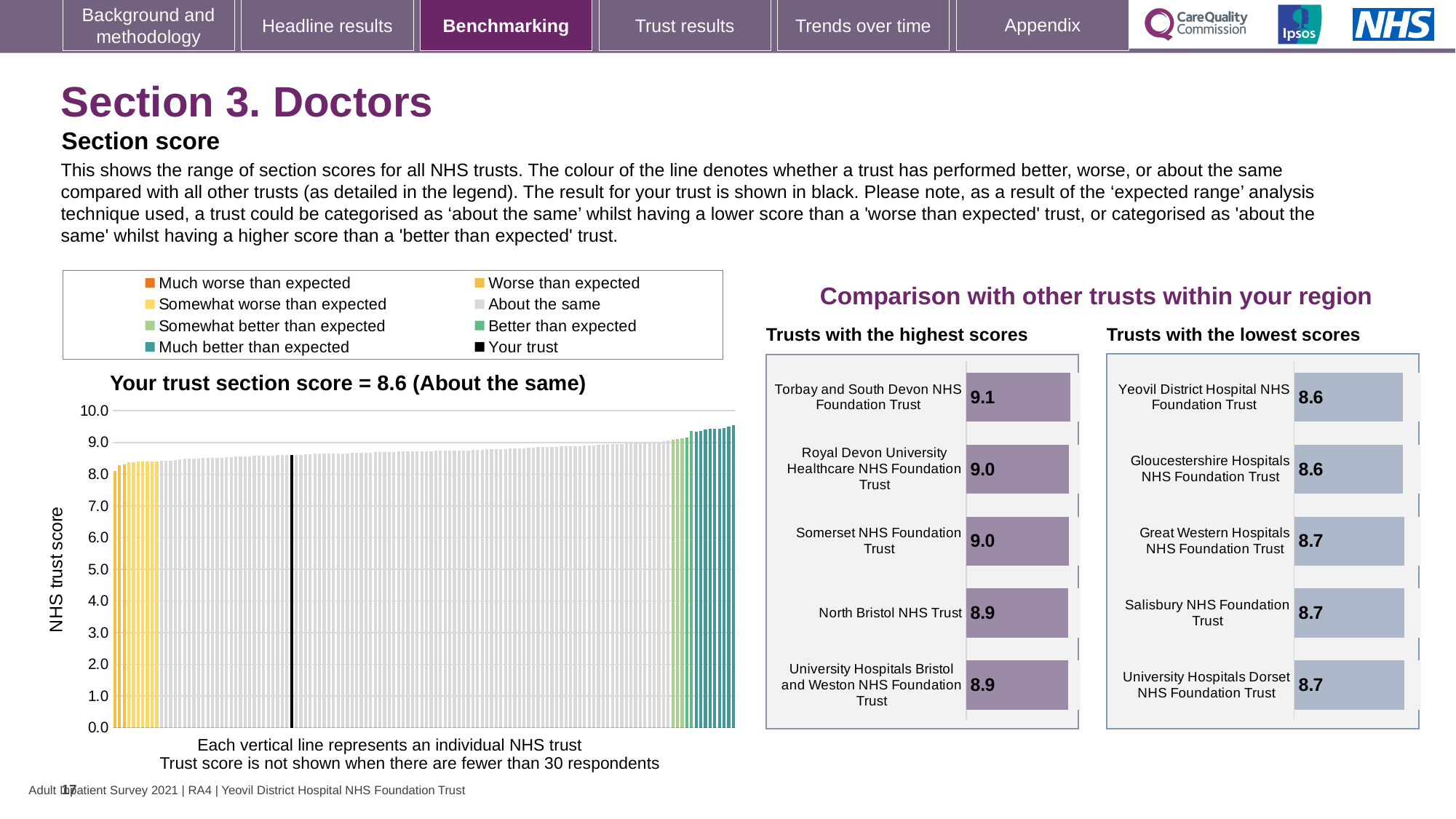
On the 'Trusts with the lowest scores' chart, what is the difference between the scores of Salisbury NHS Foundation Trust and Yeovil District Hospital NHS Foundation Trust? 0.1 What kind of chart is the 'Your trust section score' chart? bar chart On the 'Trusts with the highest scores' chart, what is the difference between the scores of Torbay and South Devon NHS Foundation Trust and North Bristol NHS Trust? 0.2 On the 'Your trust section score' chart, what is the section score for your trust? 8.6 On the 'Trusts with the lowest scores' chart, what is the score for Great Western Hospitals NHS Foundation Trust? 8.7 On the 'Trusts with the highest scores' chart, which trust has the highest score? Torbay and South Devon NHS Foundation Trust How many entries does the legend above the 'Your trust section score' chart list? 8 On the 'Trusts with the highest scores' chart, what is the score for Torbay and South Devon NHS Foundation Trust? 9.1 On the 'Your trust section score' chart, is the value of the lowest-scoring trust greater or less than 7.0? greater Which has the larger score: Somerset NHS Foundation Trust on the 'Trusts with the highest scores' chart or University Hospitals Dorset NHS Foundation Trust on the 'Trusts with the lowest scores' chart? Somerset NHS Foundation Trust On the 'Your trust section score' chart, what is the label of the vertical axis? NHS trust score On the 'Trusts with the highest scores' chart, how many trusts are shown? 5